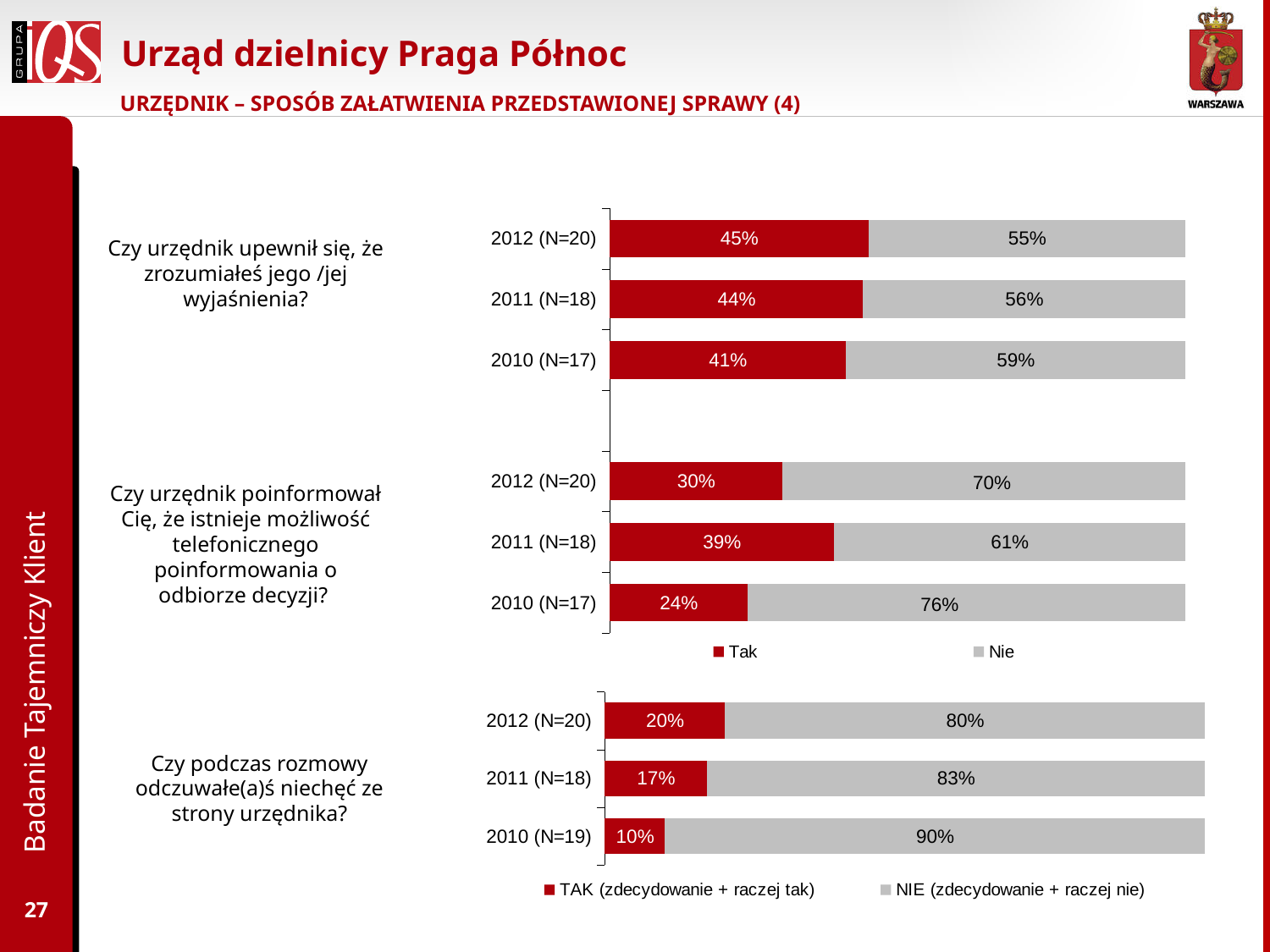
In the top chart ("Czy urzędnik upewnił się, że zrozumiałeś jego/jej wyjaśnienia?"), which year has the lowest Tak value? 2010 (N=17) In the middle chart ("Czy urzędnik poinformował Cię, że istnieje możliwość telefonicznego poinformowania o odbiorze decyzji?"), what is the Tak value for 2011 (N=18)? 39% In the bottom chart ("Czy podczas rozmowy odczuwałe(a)ś niechęć ze strony urzędnika?"), what is the NIE value for 2011 (N=18)? 83% In the top chart ("Czy urzędnik upewnił się, że zrozumiałeś jego/jej wyjaśnienia?"), what is the Nie value for 2010 (N=17)? 59% What kind of chart is used on this slide? stacked bar chart In the bottom chart ("Czy podczas rozmowy odczuwałe(a)ś niechęć ze strony urzędnika?"), is the TAK value for 2012 (N=20) larger or smaller than for 2011 (N=18)? larger In the middle chart ("Czy urzędnik poinformował Cię..."), what is the difference between the Nie values for 2010 (N=17) and 2012 (N=20)? 6% How many series does the legend of the bottom chart list? 2 In the top chart ("Czy urzędnik upewnił się, że zrozumiałeś jego/jej wyjaśnienia?"), what is the Tak value for 2012 (N=20)? 45% In the middle chart ("Czy urzędnik poinformował Cię..."), which year has the highest Tak value? 2011 (N=18) In the bottom chart ("Czy podczas rozmowy odczuwałe(a)ś niechęć ze strony urzędnika?"), what is the TAK value for 2010 (N=19)? 10% In the bottom chart ("Czy podczas rozmowy odczuwałe(a)ś niechęć ze strony urzędnika?"), does the TAK value rise or fall from 2010 to 2012? rise